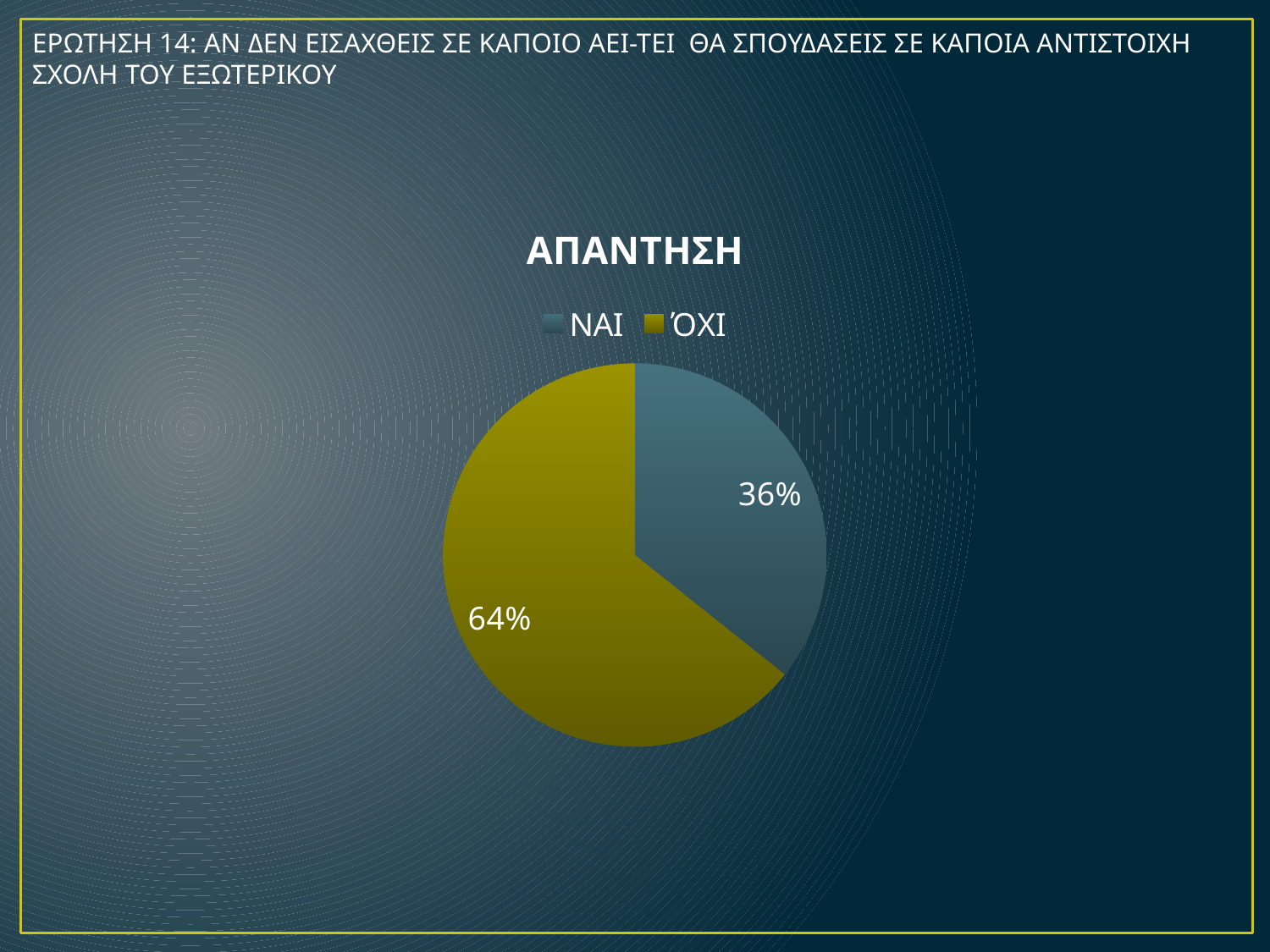
How many slices does the pie chart have? 2 What is the chart's title? ΑΠΑΝΤΗΣΗ What percentage is shown for ΝΑΙ? 36% How many entries does the legend list? 2 Which category has the largest share of the pie? ΌΧΙ Which category has the smallest share of the pie? ΝΑΙ Which is larger, the share for ΝΑΙ or the share for ΌΧΙ? ΌΧΙ What percentage is shown for ΌΧΙ? 64% What share of the pie does ΝΑΙ represent? 36% What is the difference in percentage points between ΌΧΙ and ΝΑΙ? 28 What colour is the ΌΧΙ slice? yellow What kind of chart is shown on the slide? pie chart